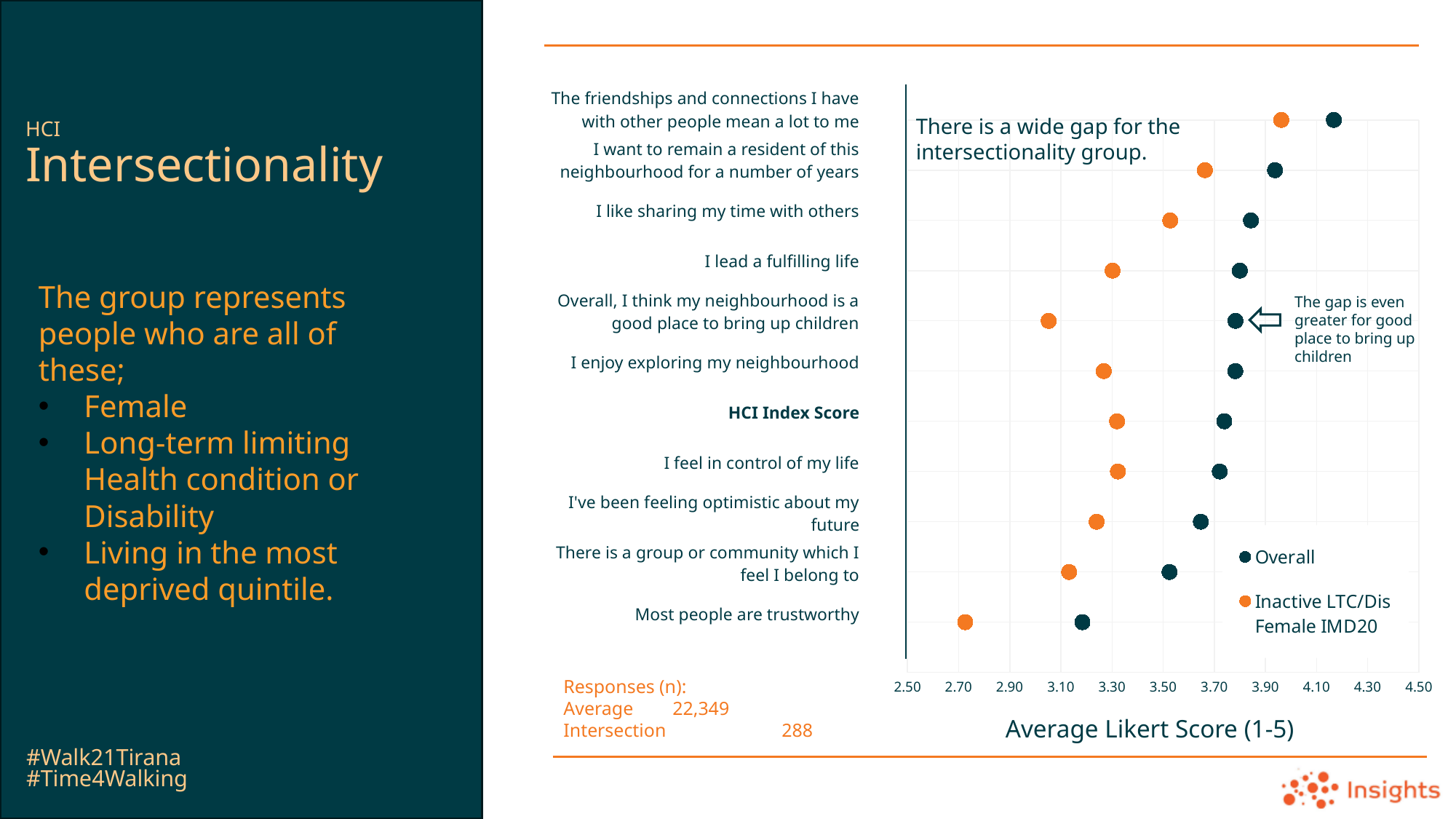
Is the Inactive LTC/Dis Female IMD20 value for 'Overall, I think my neighbourhood is a good place to bring up children' greater or less than 3.30? less For 'Most people are trustworthy', which series has the higher score: Overall or Inactive LTC/Dis Female IMD20? Overall For the Overall series, which statement has the highest average Likert score? The friendships and connections I have with other people mean a lot to me For the Inactive LTC/Dis Female IMD20 series, which statement has the highest average Likert score? The friendships and connections I have with other people mean a lot to me For the Overall series, which statement has the lowest average Likert score? Most people are trustworthy How many statements (categories) are plotted on the chart? 11 How many series does the chart's legend list? 2 Is the Inactive LTC/Dis Female IMD20 value for 'Most people are trustworthy' greater or less than 2.90? less What is the title of the chart's horizontal axis? Average Likert Score (1-5) For the Inactive LTC/Dis Female IMD20 series, which statement has the lowest average Likert score? Most people are trustworthy Is the Overall value for 'The friendships and connections I have with other people mean a lot to me' greater or less than 3.90? greater What kind of chart is shown on the slide? dot plot